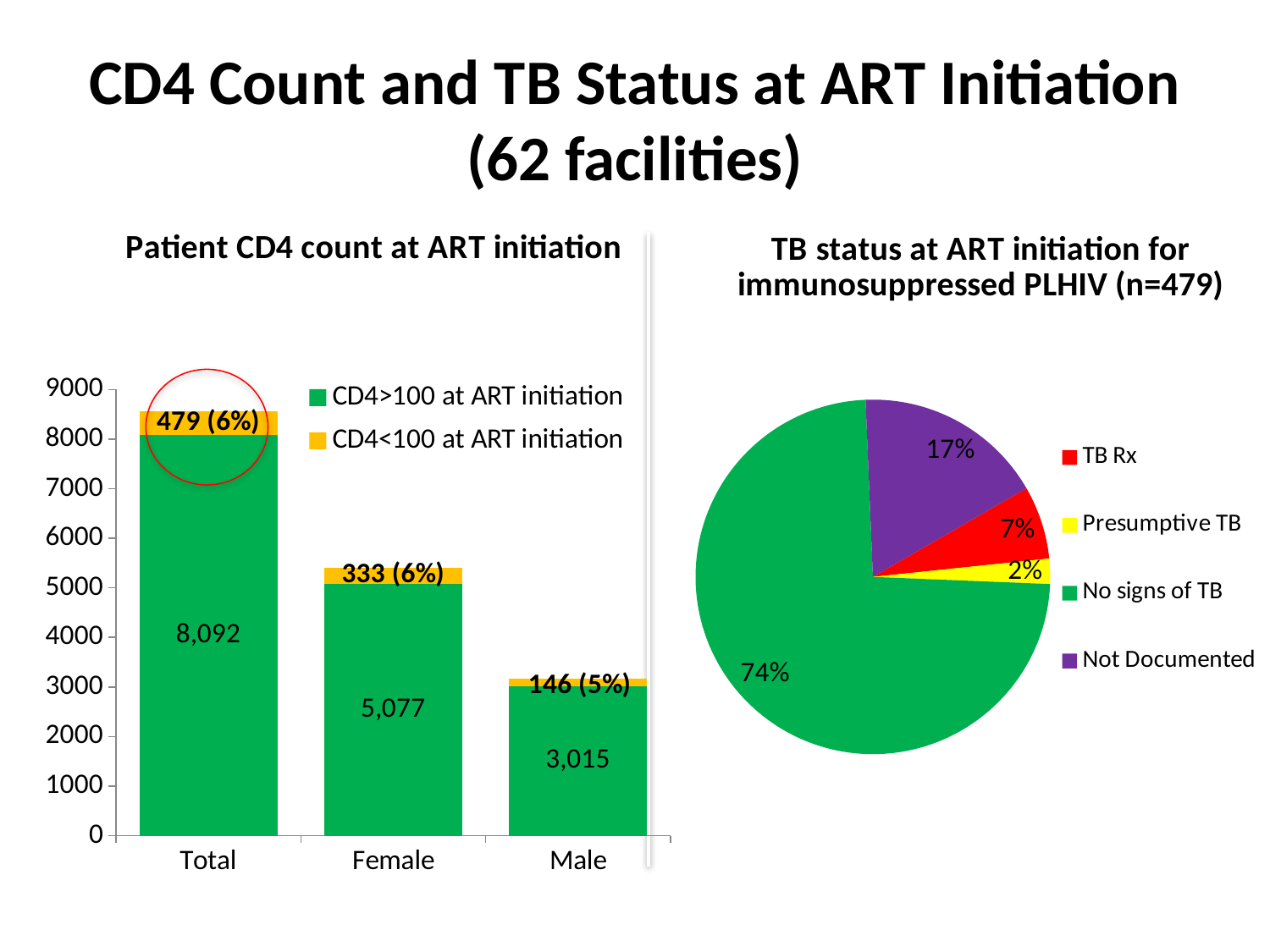
In the 'TB status at ART initiation for immunosuppressed PLHIV (n=479)' chart, which is larger: TB Rx or Not Documented? Not Documented In the 'Patient CD4 count at ART initiation' chart, how many series does the legend list? 2 In the 'TB status at ART initiation for immunosuppressed PLHIV (n=479)' chart, what share does No signs of TB have? 74% What kind of chart is 'TB status at ART initiation for immunosuppressed PLHIV (n=479)'? pie chart In the 'Patient CD4 count at ART initiation' chart, how many categories are shown on the x axis? 3 In the 'Patient CD4 count at ART initiation' chart, what is the data label on the CD4<100 at ART initiation segment for Male? 146 (5%) In the 'Patient CD4 count at ART initiation' chart, what is the difference between the CD4>100 values for Female and Male? 2,062 In the 'Patient CD4 count at ART initiation' chart, what is the data label on the CD4<100 at ART initiation segment for Total? 479 (6%) In the 'Patient CD4 count at ART initiation' chart, what is the value for CD4>100 at ART initiation for Female? 5,077 In the 'TB status at ART initiation for immunosuppressed PLHIV (n=479)' chart, which slice is the smallest? Presumptive TB In the 'Patient CD4 count at ART initiation' chart, which category has the lowest CD4>100 at ART initiation value? Male In the 'Patient CD4 count at ART initiation' chart, what is the total of the stacked bar for Female? 5,410